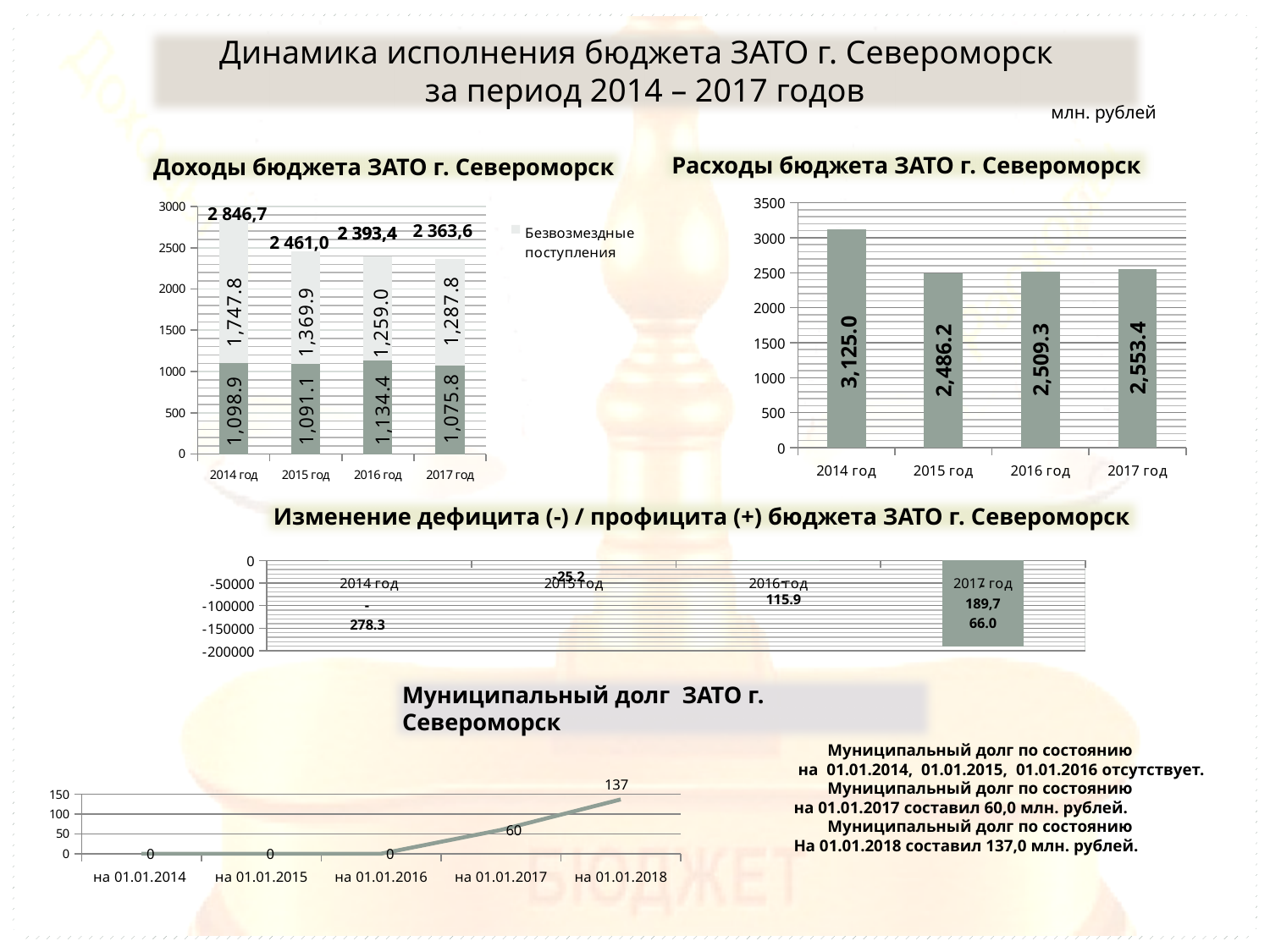
On the 'Расходы бюджета ЗАТО г. Североморск' chart, what is the difference between the values for 2017 год and 2016 год? 44.1 On the 'Доходы бюджета ЗАТО г. Североморск' chart, what is the value of the 'Безвозмездные поступления' segment for 2016 год? 1,259.0 On the 'Расходы бюджета ЗАТО г. Североморск' chart, which year has the highest value? 2014 год On the 'Муниципальный долг ЗАТО г. Североморск' chart, what is the value for на 01.01.2018? 137 On the 'Доходы бюджета ЗАТО г. Североморск' chart, how many years are shown on the x axis? 4 On the 'Муниципальный долг ЗАТО г. Североморск' chart, which is larger, the value for на 01.01.2017 or на 01.01.2018? на 01.01.2018 On the 'Расходы бюджета ЗАТО г. Североморск' chart, which year has the lowest value? 2015 год On the 'Доходы бюджета ЗАТО г. Североморск' chart, do the total values rise or fall from 2014 год to 2017 год? fall On the 'Муниципальный долг ЗАТО г. Североморск' chart, what kind of chart is it? line chart On the 'Расходы бюджета ЗАТО г. Североморск' chart, what is the value for 2014 год? 3,125.0 On the 'Доходы бюджета ЗАТО г. Североморск' chart, what is the total for 2014 год? 2 846,7 On the 'Доходы бюджета ЗАТО г. Североморск' chart, what is the value of the lower (dark) segment for 2017 год? 1,075.8